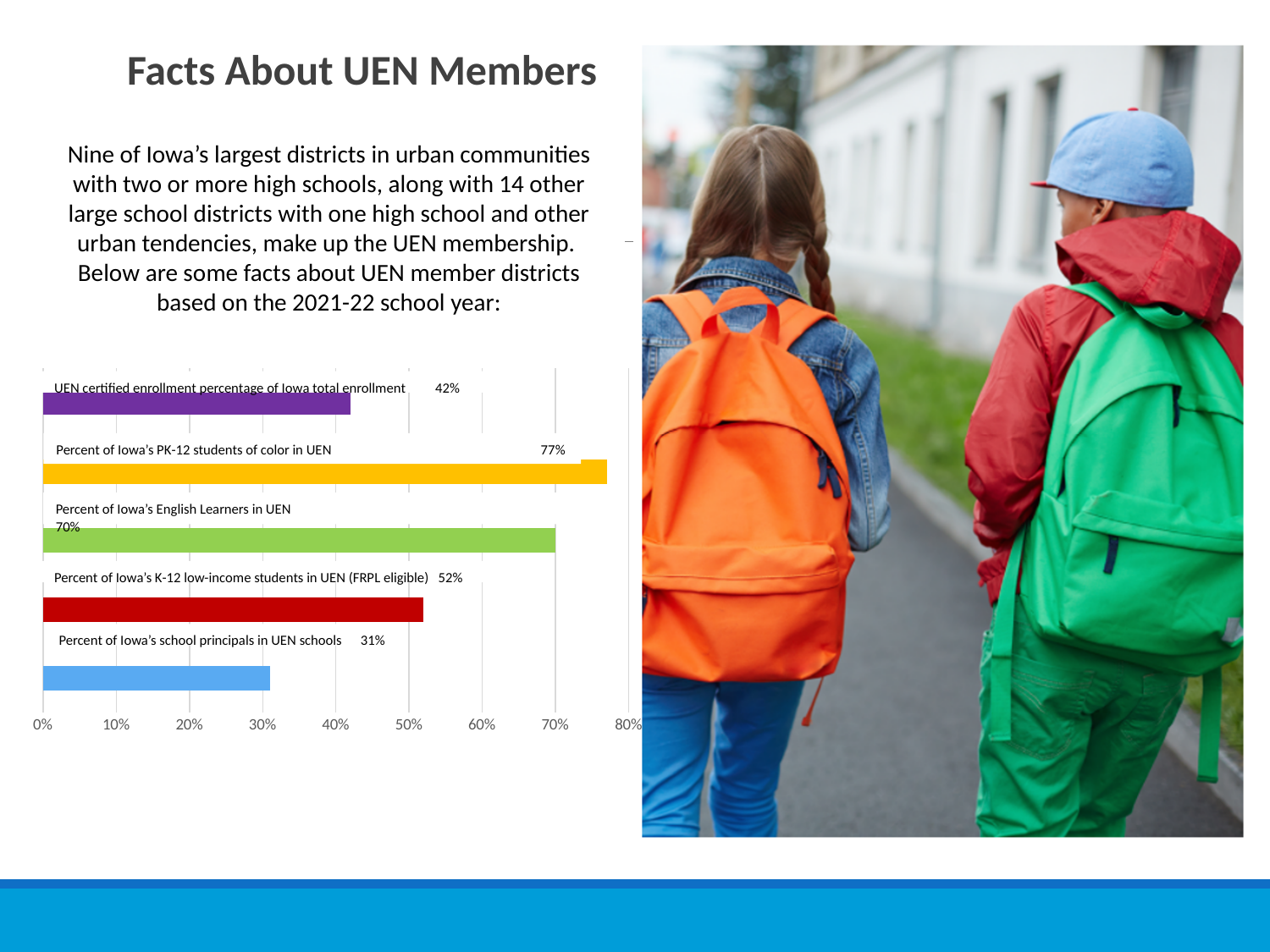
Which category has the highest value in the chart? Percent of Iowa's PK-12 students of color in UEN Which is larger: the percent of Iowa's K-12 low-income students in UEN or the UEN certified enrollment percentage of Iowa total enrollment? Percent of Iowa's K-12 low-income students in UEN (FRPL eligible) What colour is the bar for the percent of Iowa's school principals in UEN schools? Blue How many categories are shown in the chart? 5 What percent of Iowa's English Learners are in UEN? 70% What kind of chart is shown on the slide? Bar chart Which category has the lowest value in the chart? Percent of Iowa's school principals in UEN schools What percent of Iowa's K-12 low-income students (FRPL eligible) are in UEN? 52% What is the UEN certified enrollment percentage of Iowa total enrollment? 42% What percent of Iowa's school principals are in UEN schools? 31% What percent of Iowa's PK-12 students of color are in UEN? 77% What is the difference between the percent of Iowa's PK-12 students of color in UEN and the percent of Iowa's English Learners in UEN? 7%